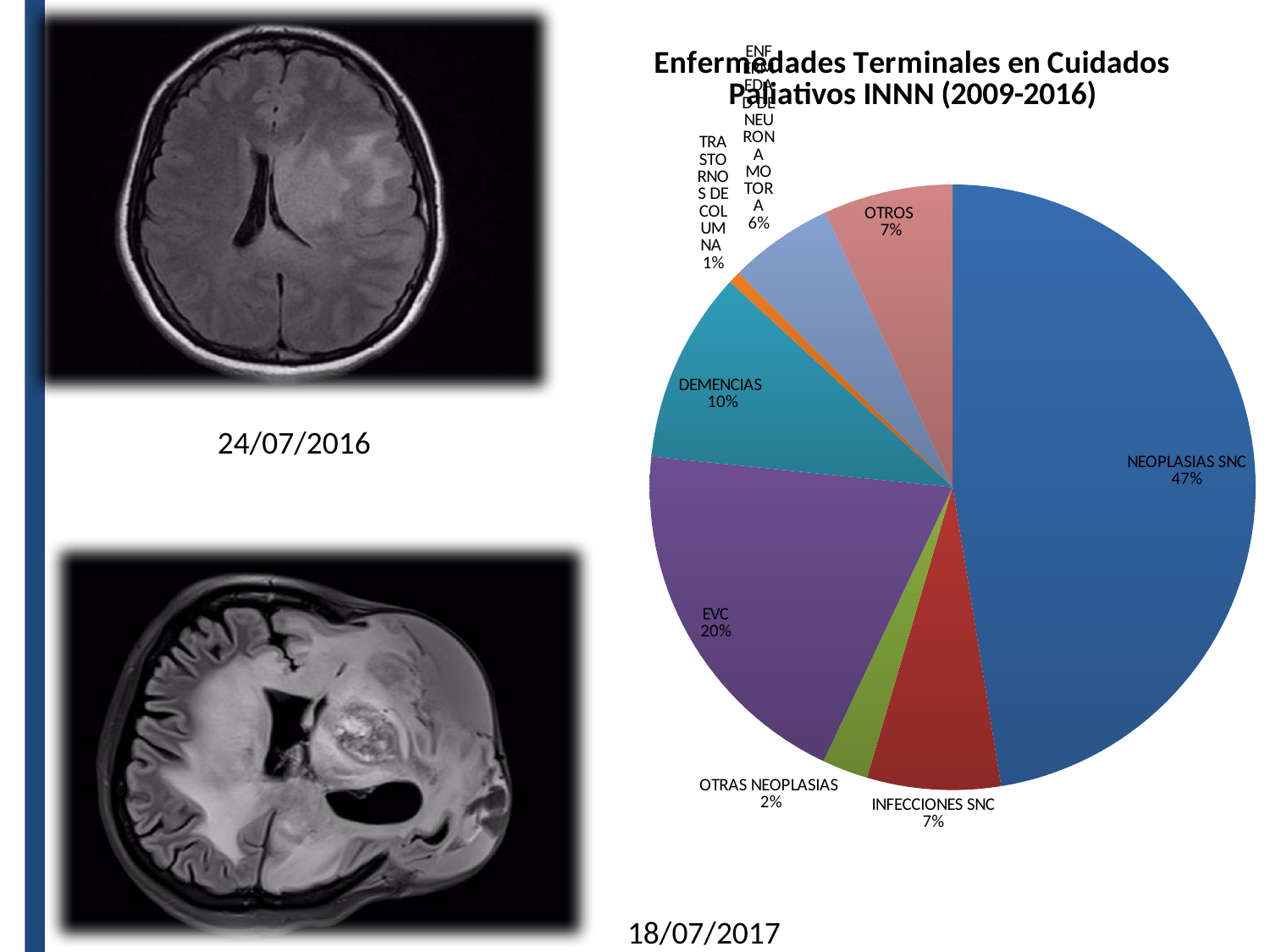
What percentage is shown for INFECCIONES SNC? 7% Which category has the largest share of the pie? NEOPLASIAS SNC What is the title of the chart? Enfermedades Terminales en Cuidados Paliativos INNN (2009-2016) What percentage is shown for OTRAS NEOPLASIAS? 2% Which category has the smallest share of the pie? TRASTORNOS DE COLUMNA What is the difference in percentage points between NEOPLASIAS SNC and EVC? 27 What kind of chart is shown on the slide? pie chart Which is larger, the share for DEMENCIAS or the share for OTROS? DEMENCIAS How many slices does the pie chart have? 8 What percentage is shown for DEMENCIAS? 10% What percentage is shown for EVC? 20% What share of the pie does NEOPLASIAS SNC represent? 47%